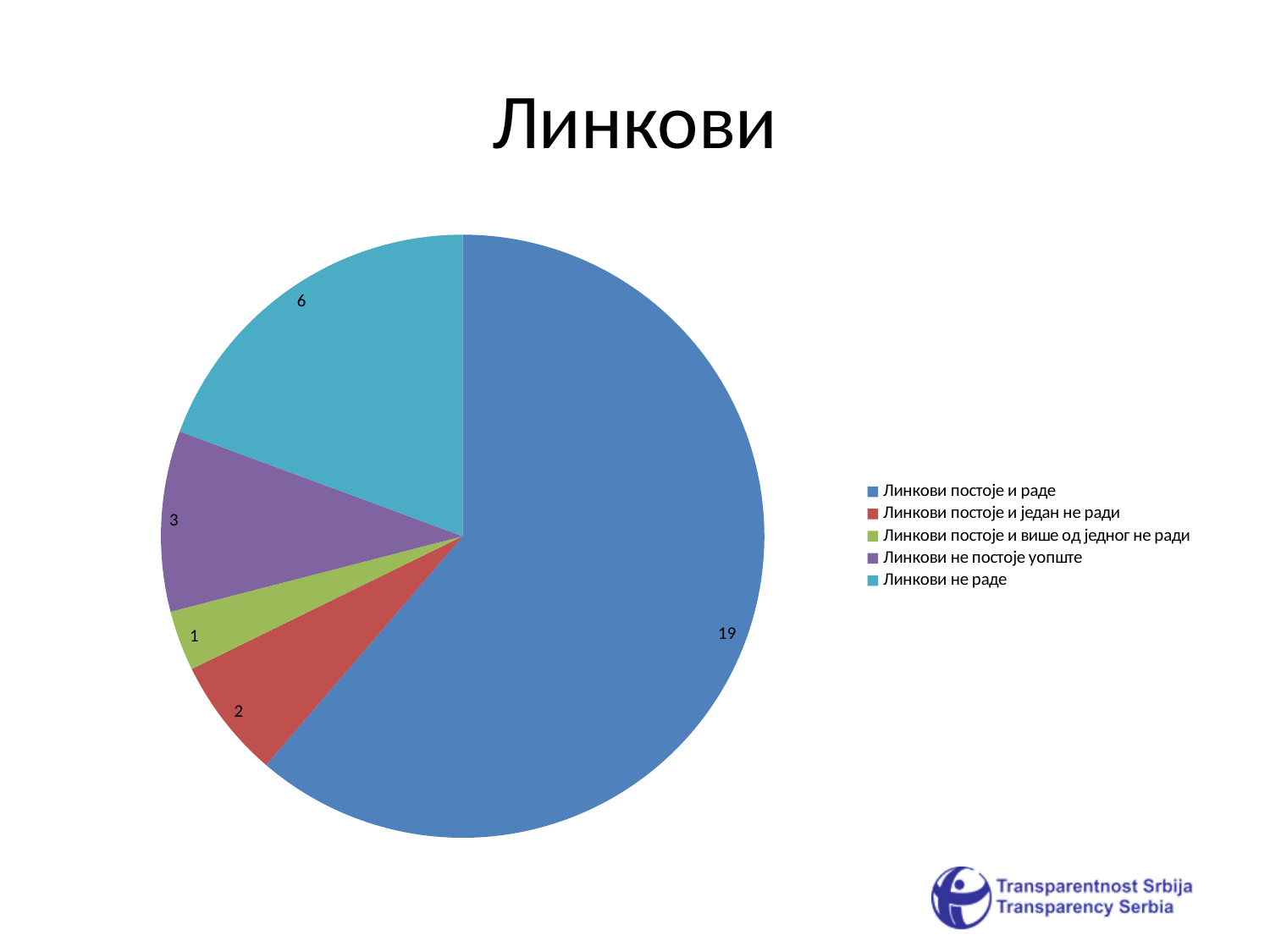
Which category has the largest slice? Линкови постоје и раде What type of chart is shown on the slide? pie chart Which category has the smallest slice? Линкови постоје и више од једног не ради What is the value for 'Линкови постоје и један не ради'? 2 What is the total of all the slice values in the pie chart? 31 Which is larger, the value for 'Линкови не постоје уопште' or the value for 'Линкови постоје и један не ради'? Линкови не постоје уопште What is the title of the chart? Линкови How many slices does the pie chart have? 5 What is the value for 'Линкови постоје и раде'? 19 What is the value for 'Линкови не раде'? 6 What is the value for 'Линкови не постоје уопште'? 3 What is the difference between the values for 'Линкови постоје и раде' and 'Линкови не раде'? 13